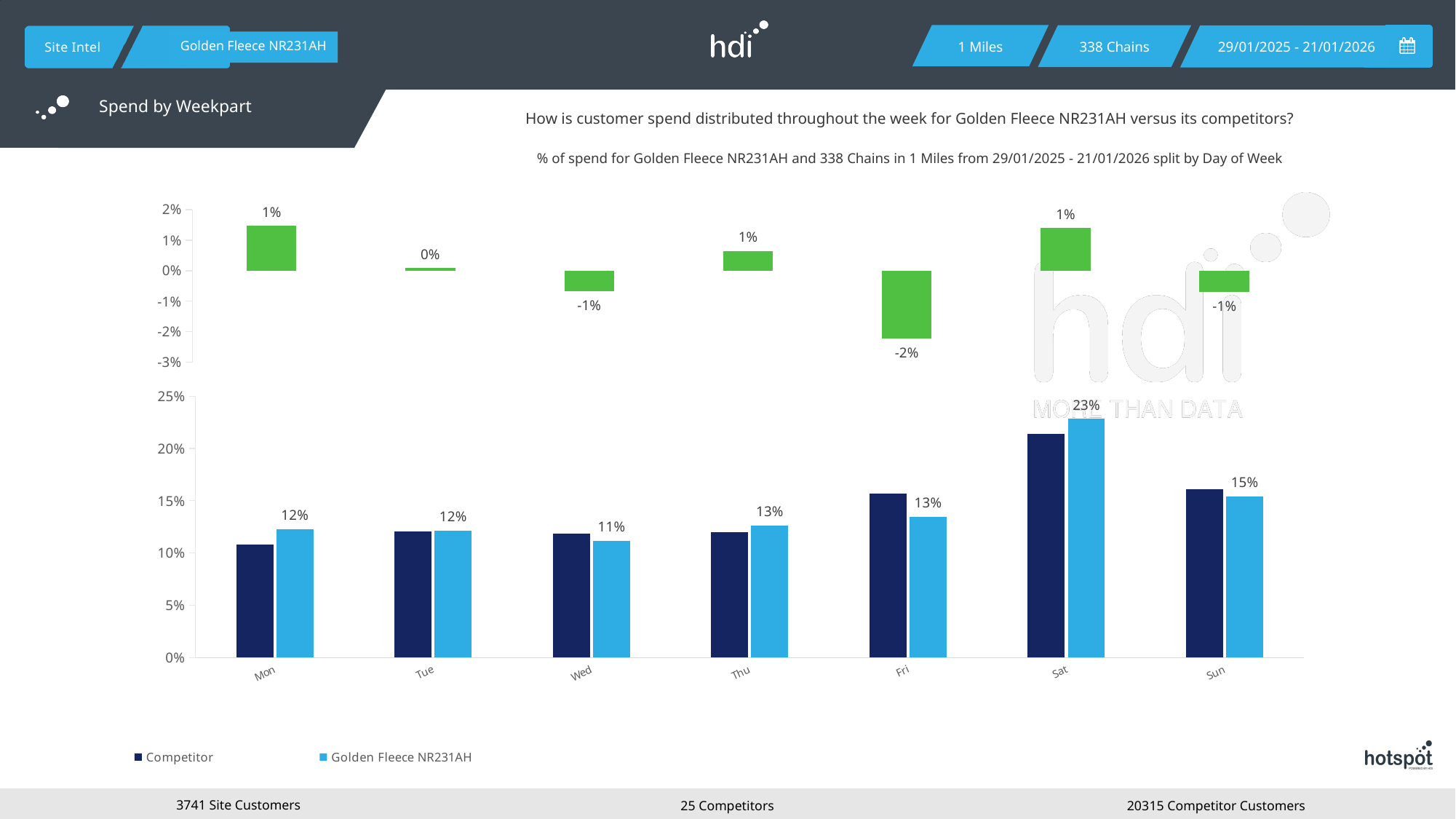
In the bottom bar chart, what is the value for Golden Fleece NR231AH on Sat? 23% In the bottom bar chart, what is the difference between the Golden Fleece NR231AH values for Sat and Sun? 8% In the bottom bar chart, is the Competitor value for Sat greater or less than 20%? greater In the top chart, which day has the lowest value? Fri In the bottom bar chart, which day has the highest value for Golden Fleece NR231AH? Sat In the bottom bar chart, which day has the lowest value for Golden Fleece NR231AH? Wed In the top chart, what is the value shown for Fri? -2% In the bottom bar chart, how many days are shown on the x axis? 7 In the bottom bar chart, is the Competitor value for Mon greater or less than 15%? less What kind of chart is the bottom chart? bar chart In the bottom bar chart, how many series does the legend list? 2 In the bottom bar chart, what is the value for Golden Fleece NR231AH on Wed? 11%